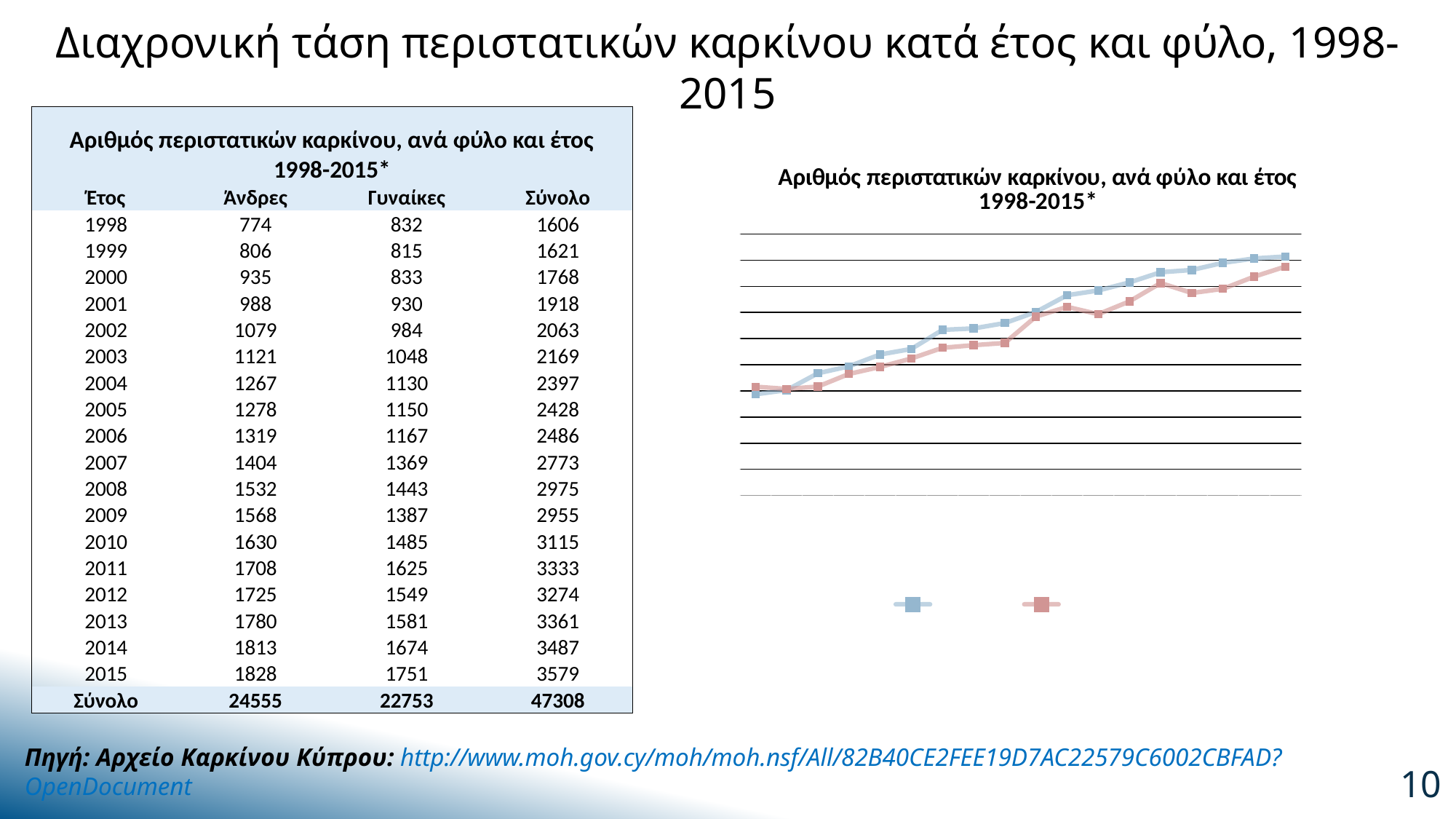
How many data points does each line in the chart have? 18 What colours are the two lines in the chart? blue and red At the rightmost point of the chart, which line is higher, the blue or the red? blue How many series does the legend of the chart list? 2 What kind of chart is shown on the right of the slide? line chart What is the title of the chart? Αριθμός περιστατικών καρκίνου, ανά φύλο και έτος 1998-2015* Do the values in the chart generally rise or fall from left to right? rise